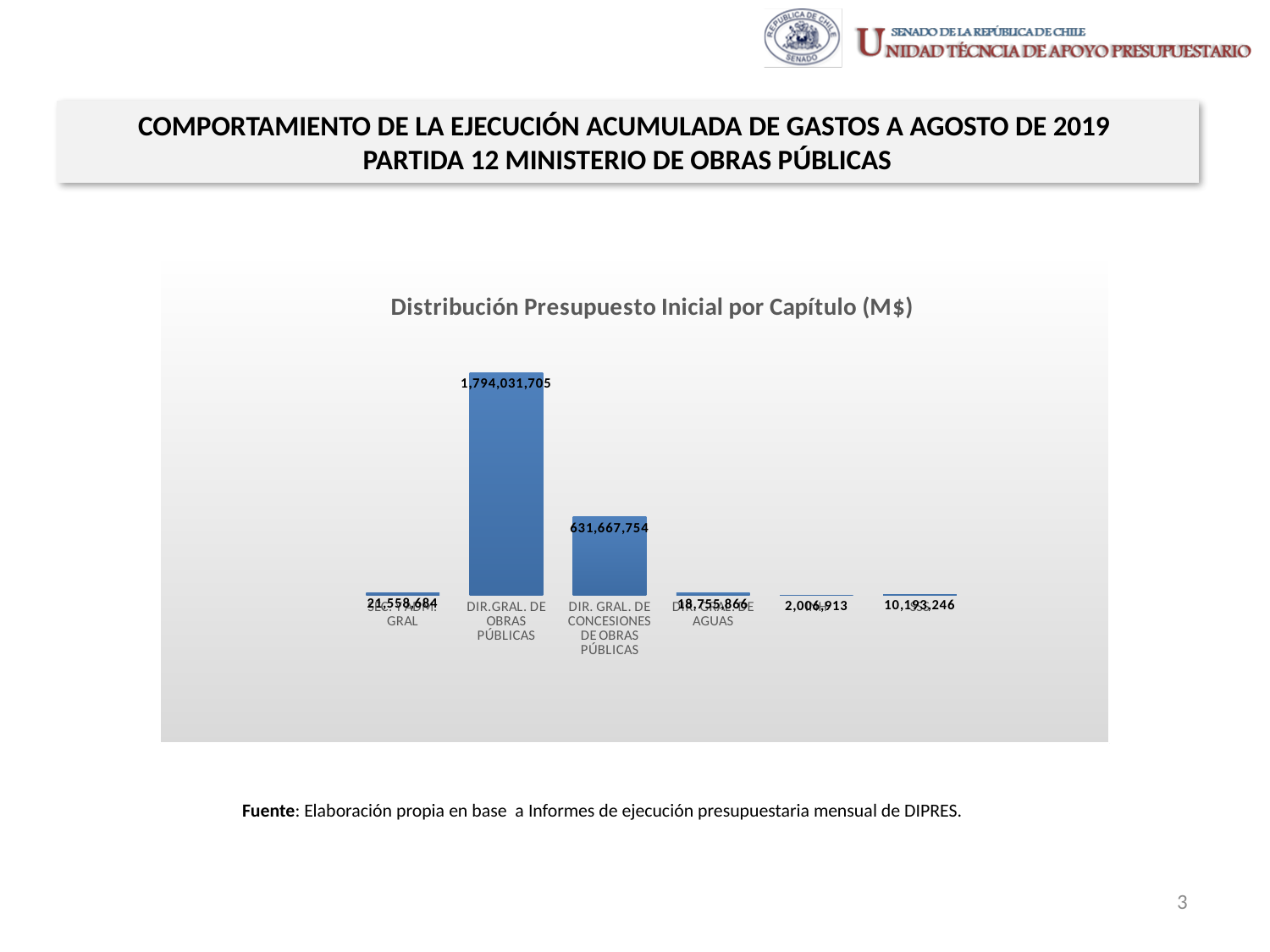
Which category has the highest value? DIR.GRAL. DE OBRAS PÚBLICAS How many bars are plotted in the chart? 6 What is the difference between the values for DIR.GRAL. DE OBRAS PÚBLICAS and DIR. GRAL. DE CONCESIONES DE OBRAS PÚBLICAS? 1,162,363,951 What is the lowest value shown in the chart? 2,006,913 What is the value for DIR. GRAL. DE AGUAS? 18,755,866 What is the title of the chart? Distribución Presupuesto Inicial por Capítulo (M$) What is the highest value shown in the chart? 1,794,031,705 Which is larger, the value for DIR. GRAL. DE CONCESIONES DE OBRAS PÚBLICAS or the value for DIR. GRAL. DE AGUAS? DIR. GRAL. DE CONCESIONES DE OBRAS PÚBLICAS What is the value for DIR. GRAL. DE CONCESIONES DE OBRAS PÚBLICAS? 631,667,754 What type of chart is shown on the slide? bar chart What unit is indicated in the chart title? M$ What is the value for DIR.GRAL. DE OBRAS PÚBLICAS? 1,794,031,705